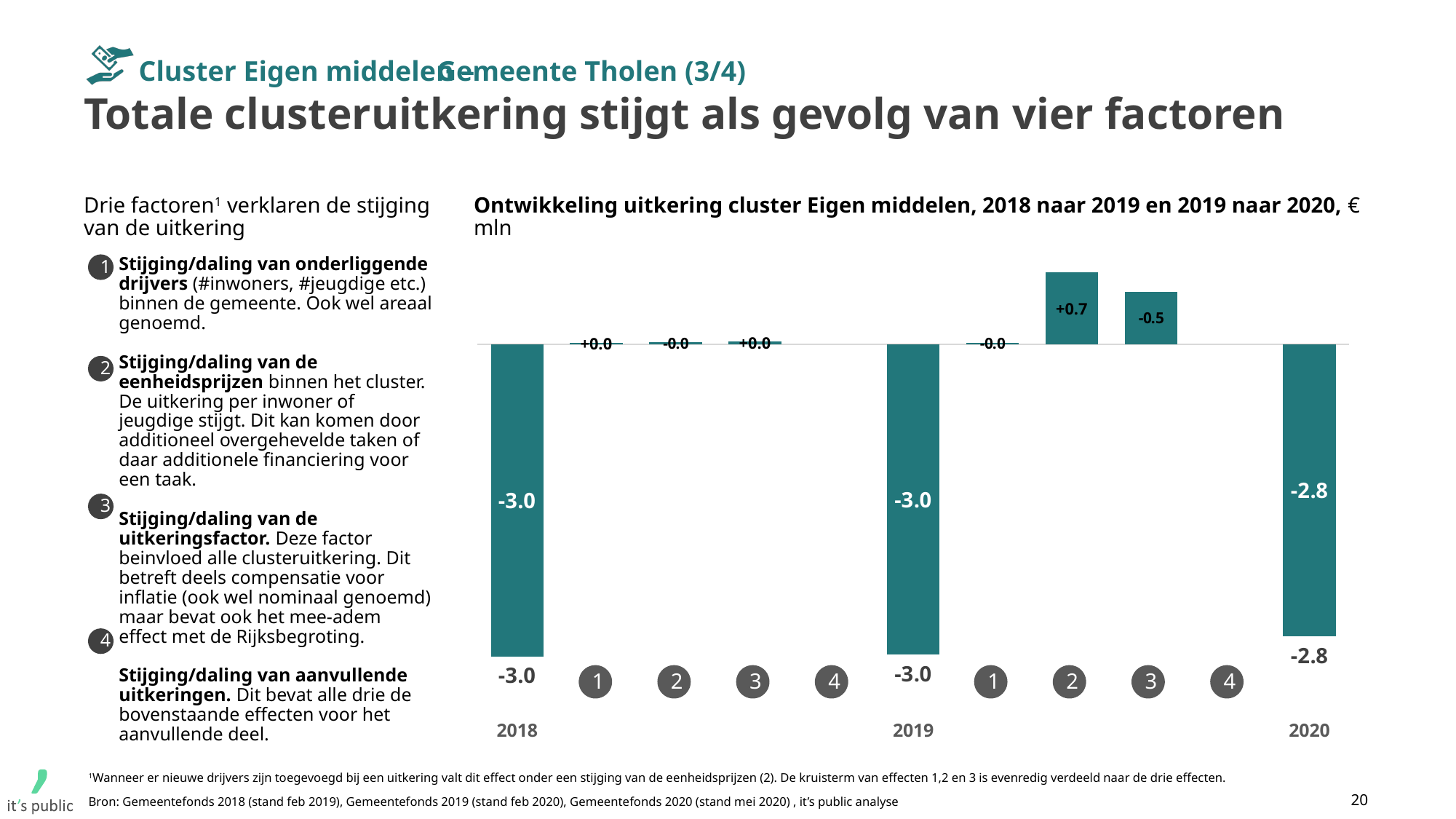
What is the value of the 2020 bar in the chart? -2.8 What is the title of the chart? Ontwikkeling uitkering cluster Eigen middelen, 2018 naar 2019 en 2019 naar 2020, € mln What is the value of factor 1 in the change from 2018 to 2019? +0.0 What is the value of factor 3 in the change from 2019 to 2020? -0.5 What is the value of the 2018 bar in the chart? -3.0 What is the difference between the 2020 value and the 2019 value? 0.2 Which years are shown as totals along the x axis of the chart? 2018, 2019, 2020 What is the value of the 2019 bar in the chart? -3.0 What kind of chart is shown on the slide? Bar chart Which factor in the change from 2019 to 2020 has the highest value? 2 What is the value of factor 2 in the change from 2019 to 2020? +0.7 Which is larger, the value for 2018 or the value for 2020? 2020